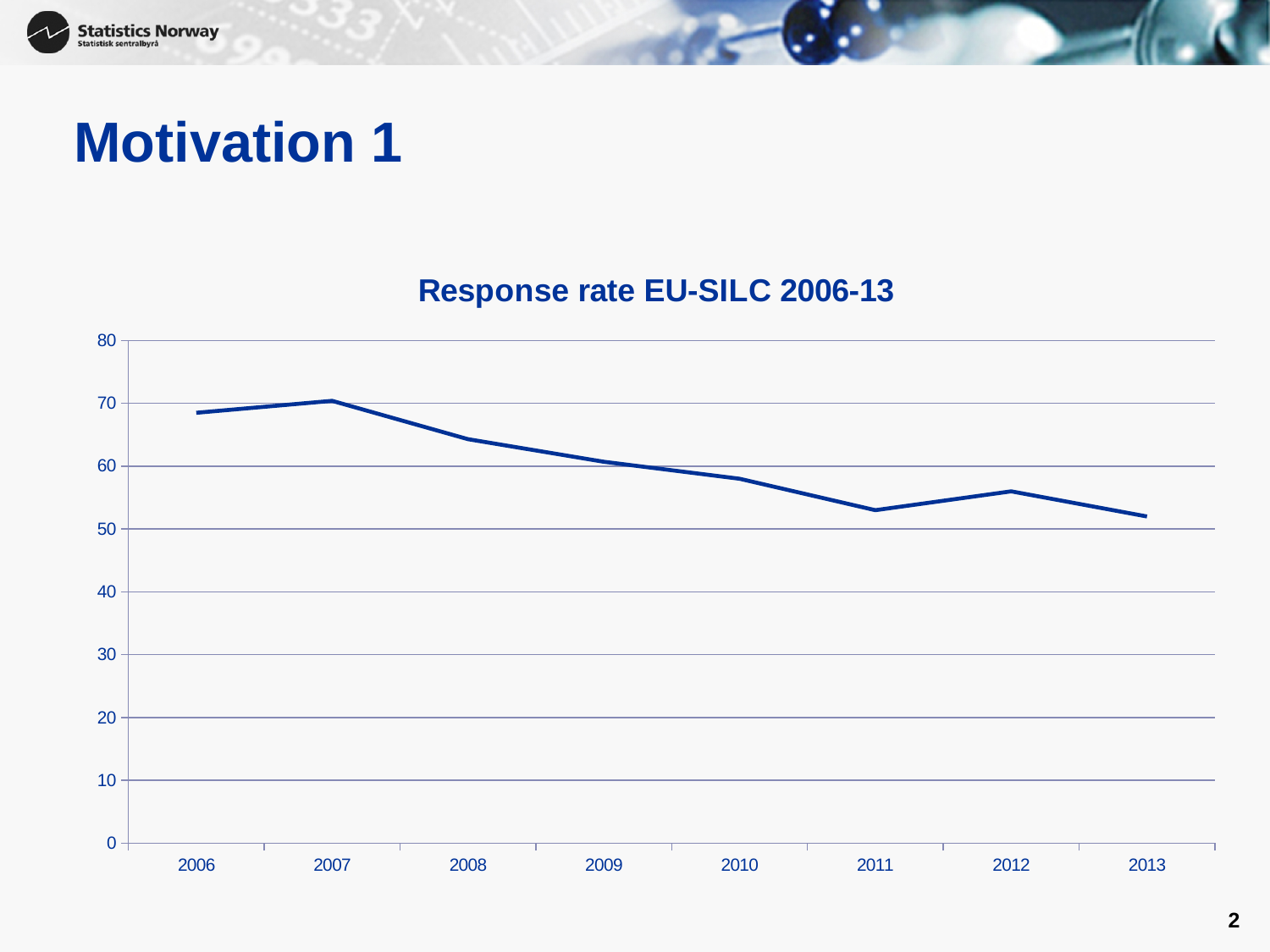
Is the value for 2013 greater or less than 50? greater Is the value for 2006 greater or less than 60? greater Is the value for 2010 greater or less than 60? less What is the title of the chart? Response rate EU-SILC 2006-13 Overall, does the response rate rise or fall from 2006 to 2013? fall Which year has the highest response rate? 2007 How many years are plotted on the x axis? 8 What kind of chart is shown on the slide? line chart Which is larger, the value for 2006 or the value for 2013? 2006 Which is larger, the value for 2008 or the value for 2010? 2008 Which is larger, the value for 2011 or the value for 2012? 2012